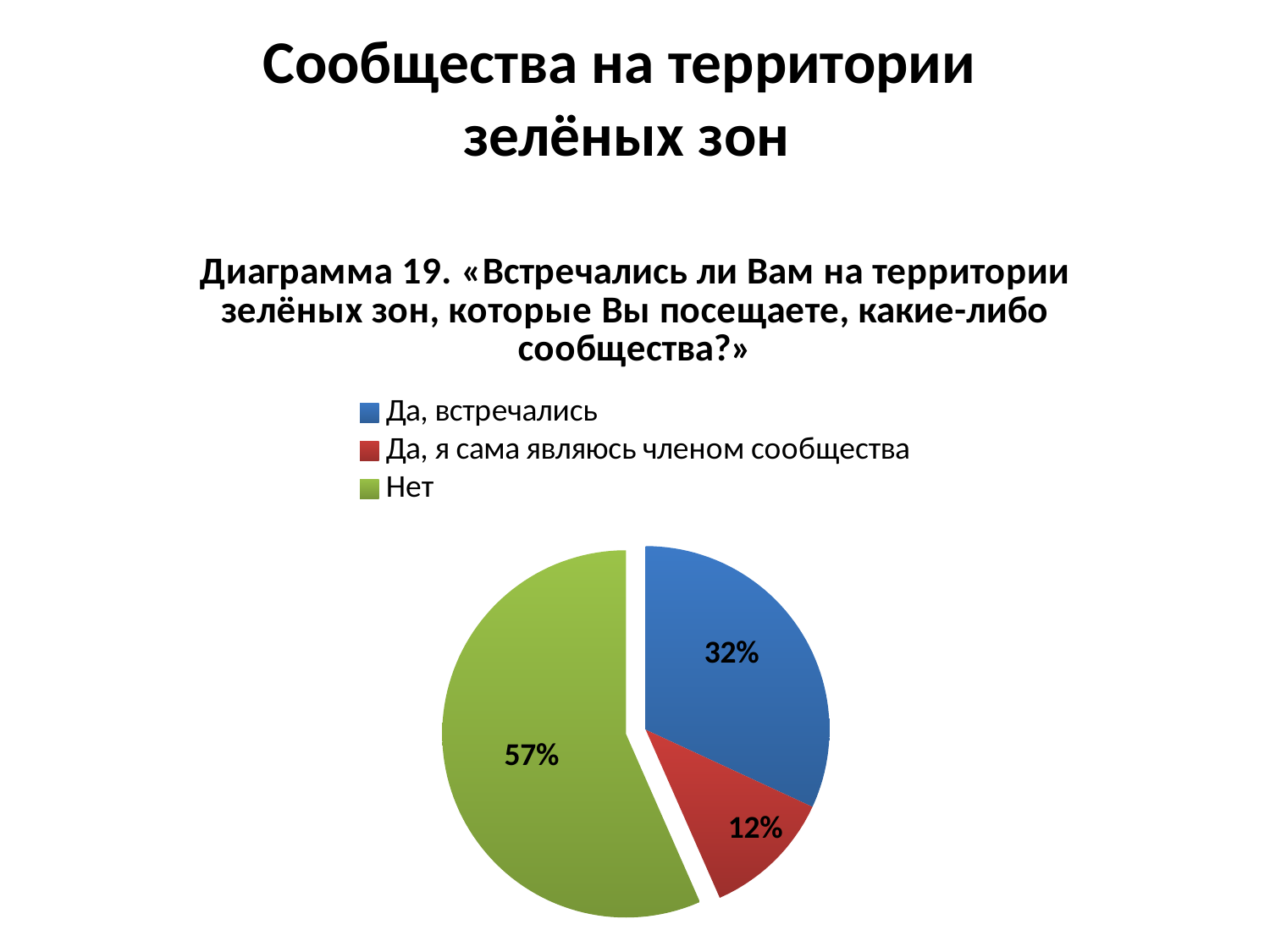
Which category has the largest slice of the pie? Нет Which category has the smallest slice of the pie? Да, я сама являюсь членом сообщества What is the difference in percentage points between "Нет" and "Да, встречались"? 25% What share of the pie does "Нет" have? 57% Which is larger: the slice for "Да, встречались" or the slice for "Да, я сама являюсь членом сообщества"? Да, встречались What is the number of the diagram given in the chart title? 19 What type of chart is shown on the slide? pie chart How many categories does the pie chart have? 3 What share of the pie does "Да, встречались" have? 32% What colour is the slice for "Нет"? green What share of the pie does "Да, я сама являюсь членом сообщества" have? 12% What is the difference in percentage points between "Да, встречались" and "Да, я сама являюсь членом сообщества"? 20%